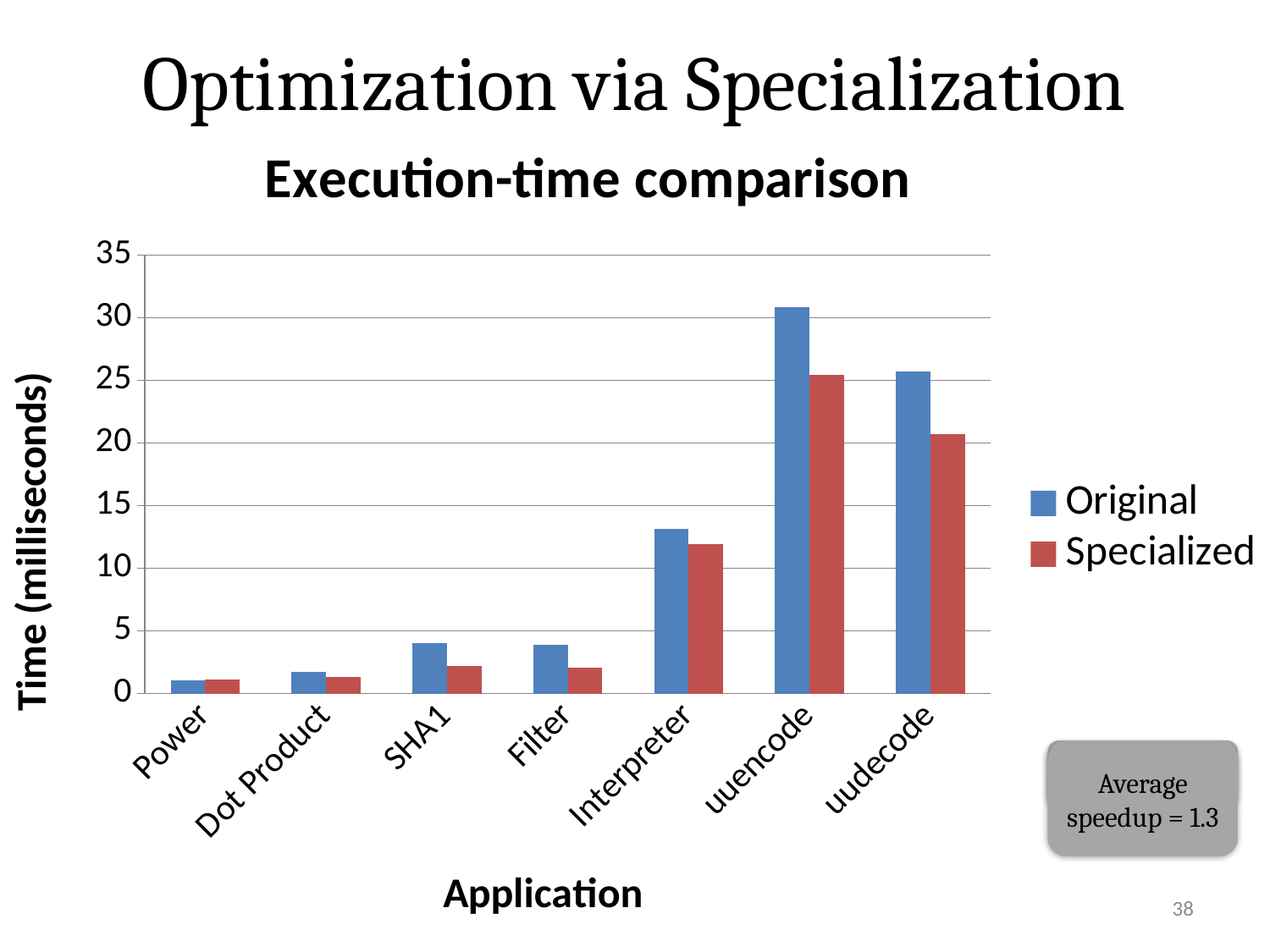
Which application has the highest Original execution time? uuencode What is the label of the y axis? Time (milliseconds) Is the Original value for Interpreter greater or less than 10? greater Which application has the lowest Original execution time? Power Is the Specialized value for uudecode greater or less than 25? less How many series does the legend list? 2 What is the title of the chart? Execution-time comparison Which is larger for uudecode, the Original or the Specialized value? Original Is the Original value for uuencode greater or less than 30? greater How many applications are shown on the x axis? 7 Which is larger, the Original value for SHA1 or the Original value for Interpreter? Interpreter What kind of chart is shown on the slide? bar chart